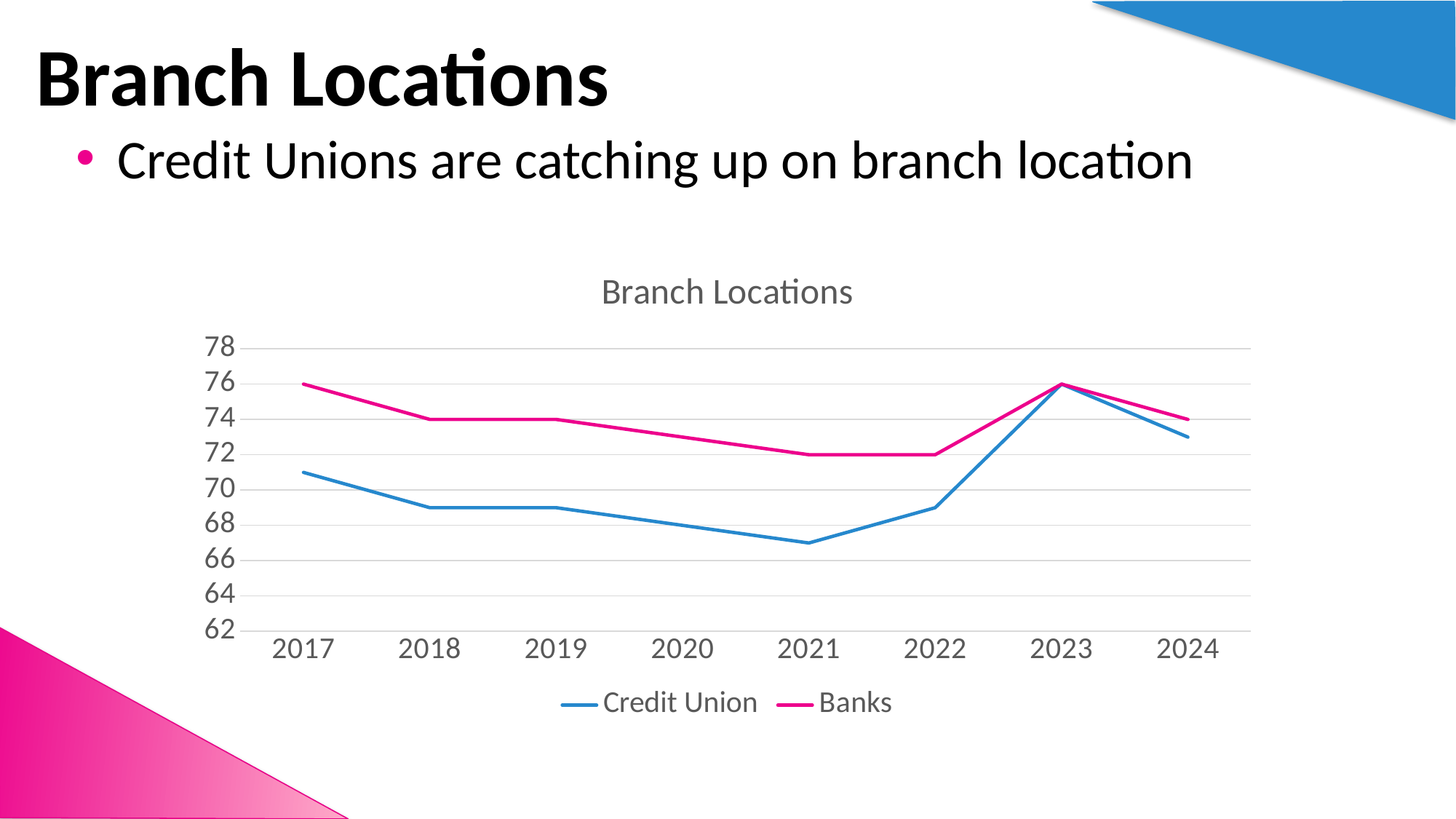
How many series does the legend list? 2 What is the value for Banks in 2021? 72 Is the value for Credit Union in 2021 greater or less than 68? less What is the value for Banks in 2017? 76 In which year is the Credit Union value lowest? 2021 What type of chart is shown on the slide? Line chart How many years are plotted along the x axis? 8 What is the value for Credit Union in 2020? 68 What is the difference between the Banks value in 2017 and in 2021? 4 In which year is the Credit Union value highest? 2023 Does the Credit Union line rise or fall from 2017 to 2021? Fall What is the value for Credit Union in 2023? 76